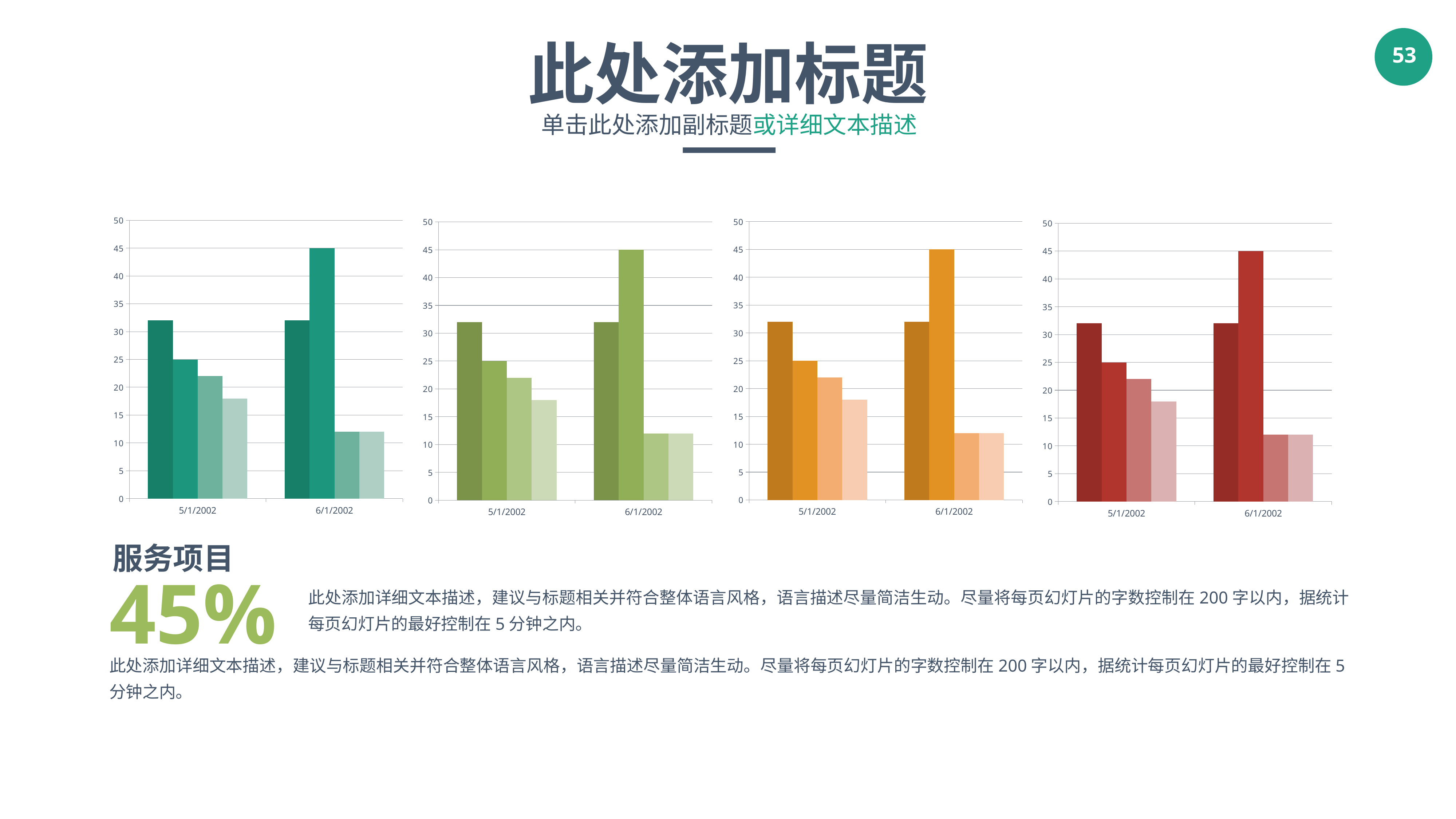
In the teal chart (leftmost), what value does the tallest bar for 6/1/2002 reach? 45 In the orange chart (third from left), which category contains the tallest bar? 6/1/2002 In the green chart (second from left), is the value of the fourth (lightest) bar for 6/1/2002 greater or less than 15? less In the red chart (rightmost), is the first bar for 5/1/2002 taller or shorter than the second bar for 5/1/2002? taller In the leftmost chart, is the value of the first (darkest) bar for 5/1/2002 greater or less than 30? greater In the orange chart (third from left), how many categories are shown on the x axis? 2 What is the highest value shown on the vertical axis of the green chart (second from left)? 50 How many charts are shown on the slide? 4 What kind of chart is the leftmost chart on the slide? bar chart In the teal chart (leftmost), how many bars are plotted for the 5/1/2002 category? 4 In the orange chart (third from left), is the value of the third bar for 5/1/2002 greater or less than 25? less In the red chart (rightmost), what value does the second bar for 5/1/2002 reach? 25